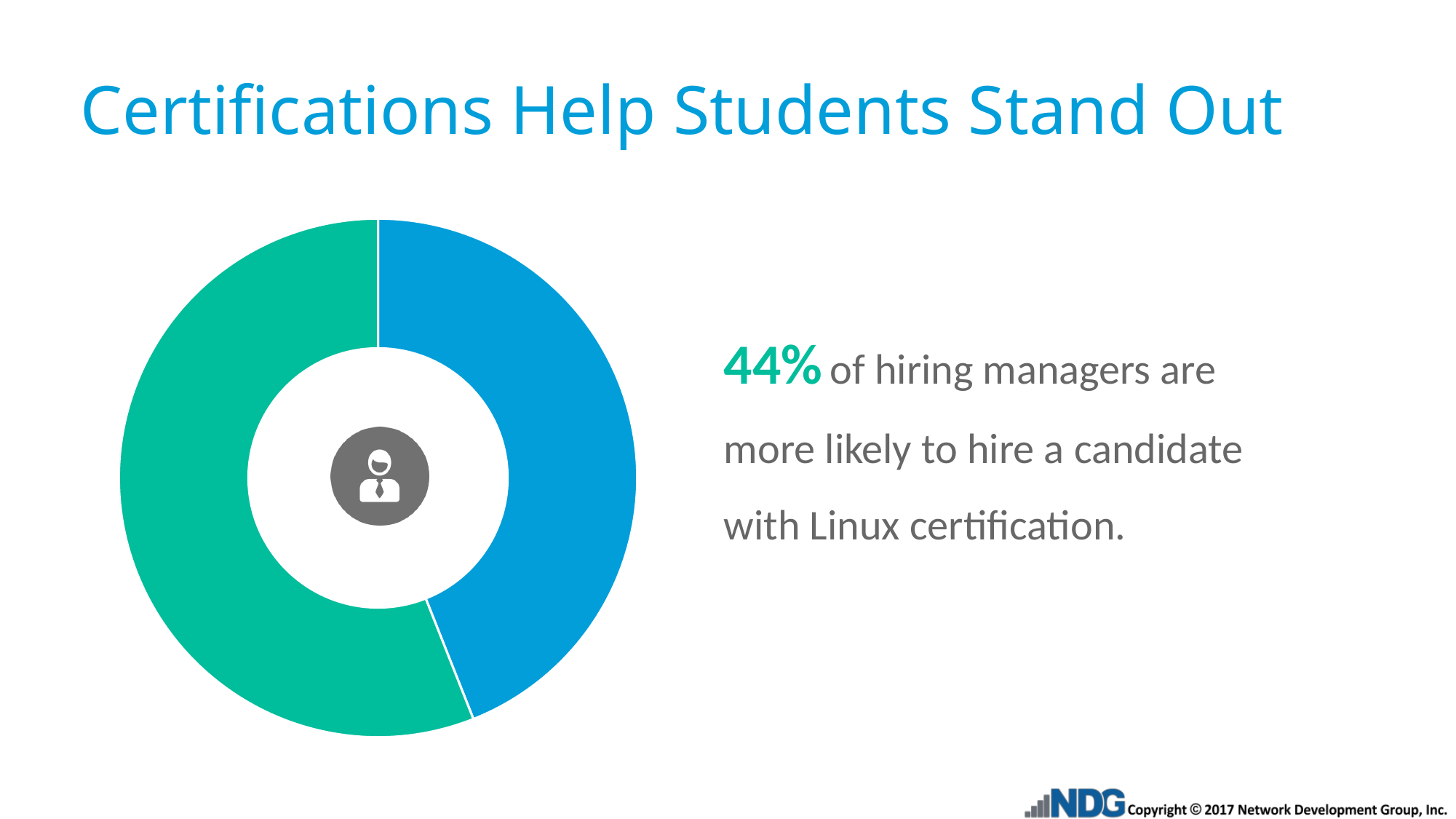
How many slices does the donut chart have? 2 What is the title of the slide containing the donut chart? Certifications Help Students Stand Out What icon appears in the centre of the donut chart? A person (hiring manager) icon Which slice of the donut chart is larger, the green one or the blue one? Green If 44% of hiring managers are more likely to hire a candidate with Linux certification, what share does the remaining slice represent? 56% What percentage of hiring managers are more likely to hire a candidate with Linux certification, according to the slide? 44% What type of chart is shown on the slide? Pie chart (donut) Is the blue slice of the donut chart greater or less than 50% of the whole? less